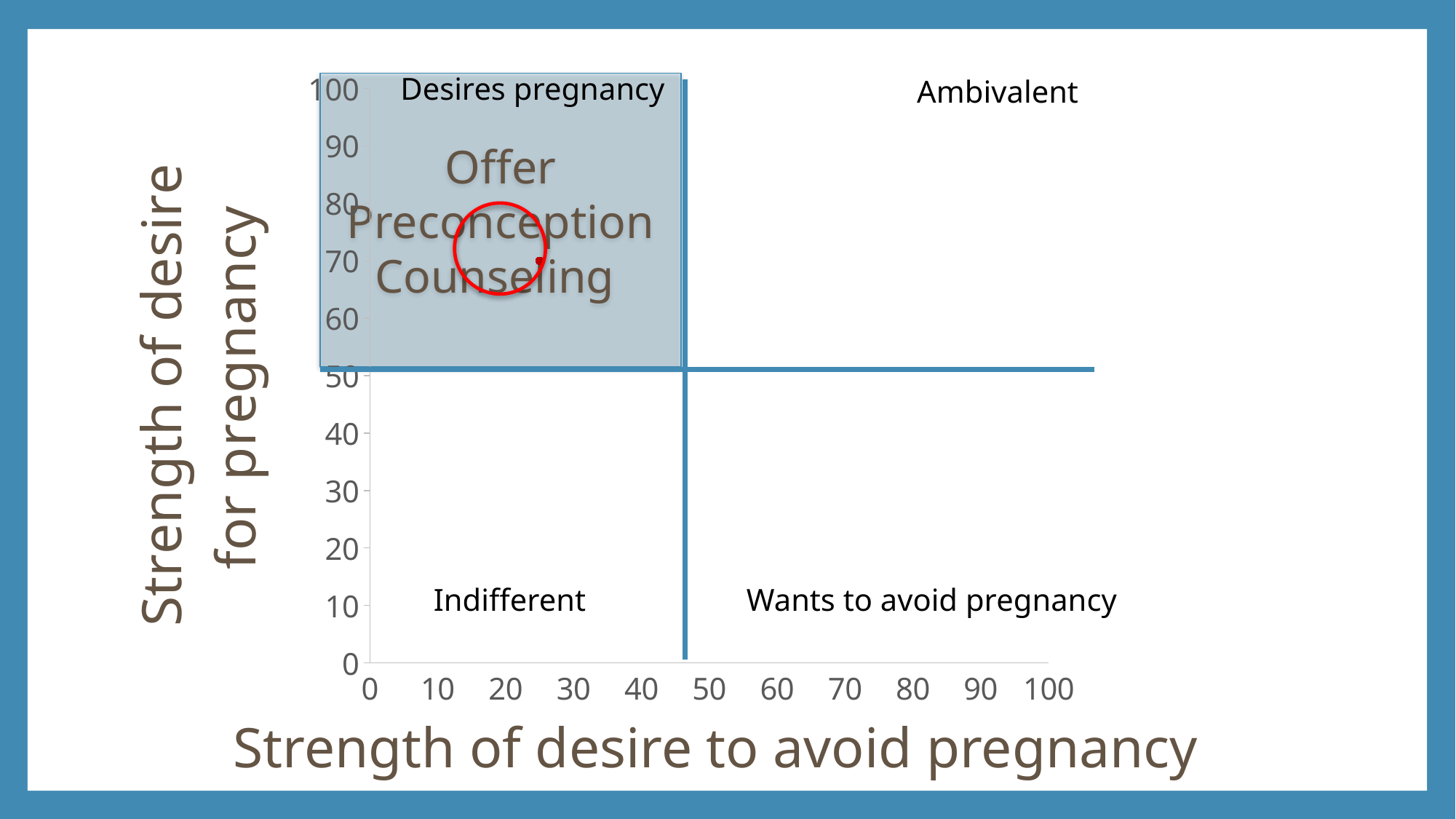
What is the label of the y axis? Strength of desire for pregnancy What is the maximum value shown on the x axis? 100 How many data points are plotted on the chart? 1 In which labelled quadrant does the plotted point fall? Desires pregnancy What is the label of the upper-right quadrant of the chart? Ambivalent What is the label of the lower-right quadrant of the chart? Wants to avoid pregnancy Is the y-axis value (strength of desire for pregnancy) of the plotted point greater or less than 50? greater What kind of chart is shown on the slide? scatter chart What is the label of the x axis? Strength of desire to avoid pregnancy Is the x-axis value of the plotted point greater or less than 40? less Is the x-axis value (strength of desire to avoid pregnancy) of the plotted point greater or less than 50? less